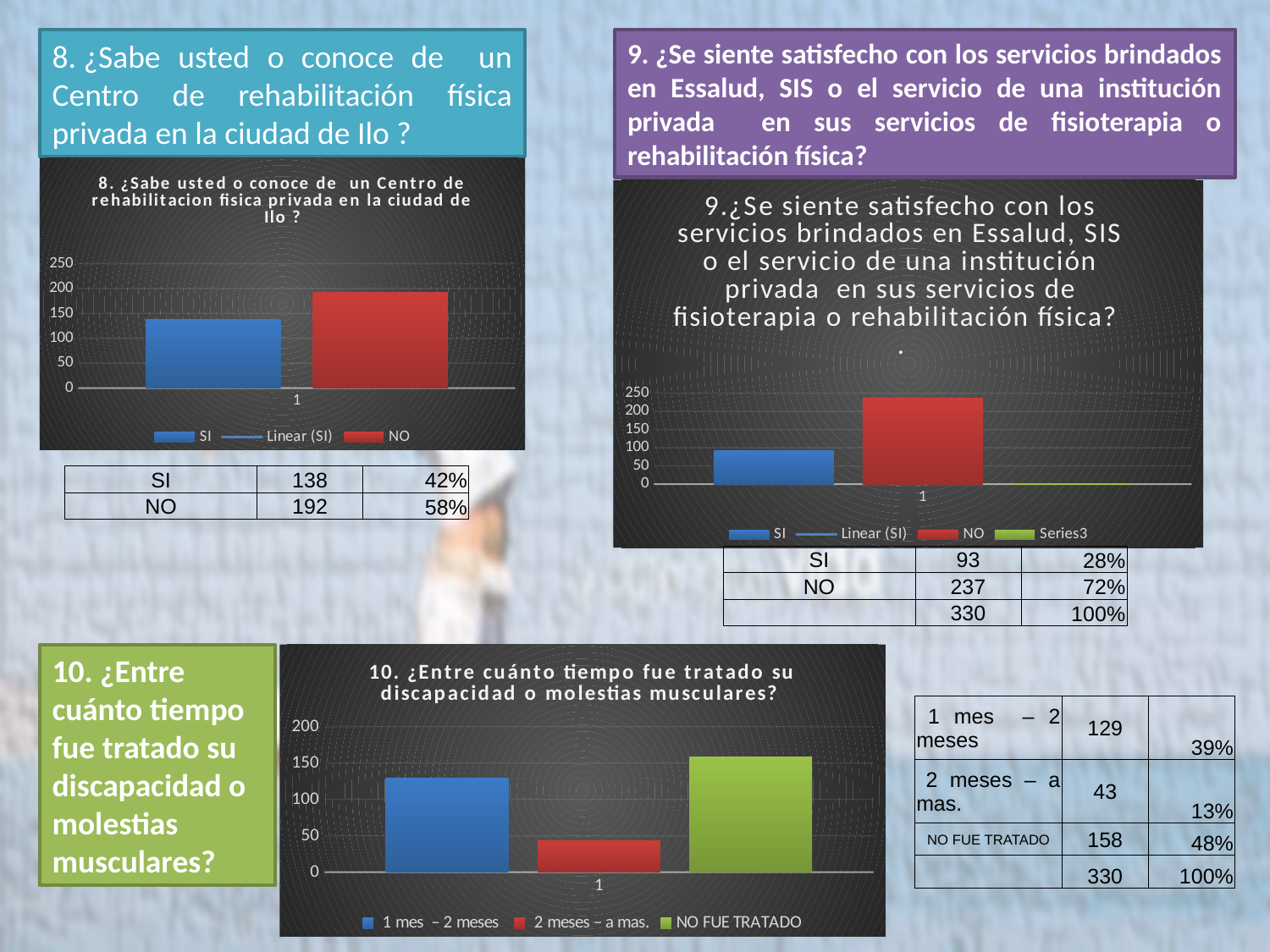
In the chart for question 10 (bottom), which category has the highest bar? NO FUE TRATADO In the chart for question 8 (top left), what is the difference between the NO and SI values? 54 In the chart for question 8 (top left), is the value for SI greater or less than 100? greater In the chart for question 9 (top right), how many entries does the legend list? 4 In the chart for question 8 (top left), what is the value for NO? 192 In the chart for question 9 (top right), what is the value for SI? 93 What type of chart is used for question 10 (bottom)? bar chart In the chart for question 8 (top left), which category has the higher bar, SI or NO? NO In the chart for question 10 (bottom), which category has the lowest bar? 2 meses – a mas. In the chart for question 9 (top right), what percentage corresponds to NO? 72% In the chart for question 10 (bottom), is the value for 2 meses – a mas. greater or less than 50? less In the chart for question 9 (top right), is the value for NO greater or less than 200? greater